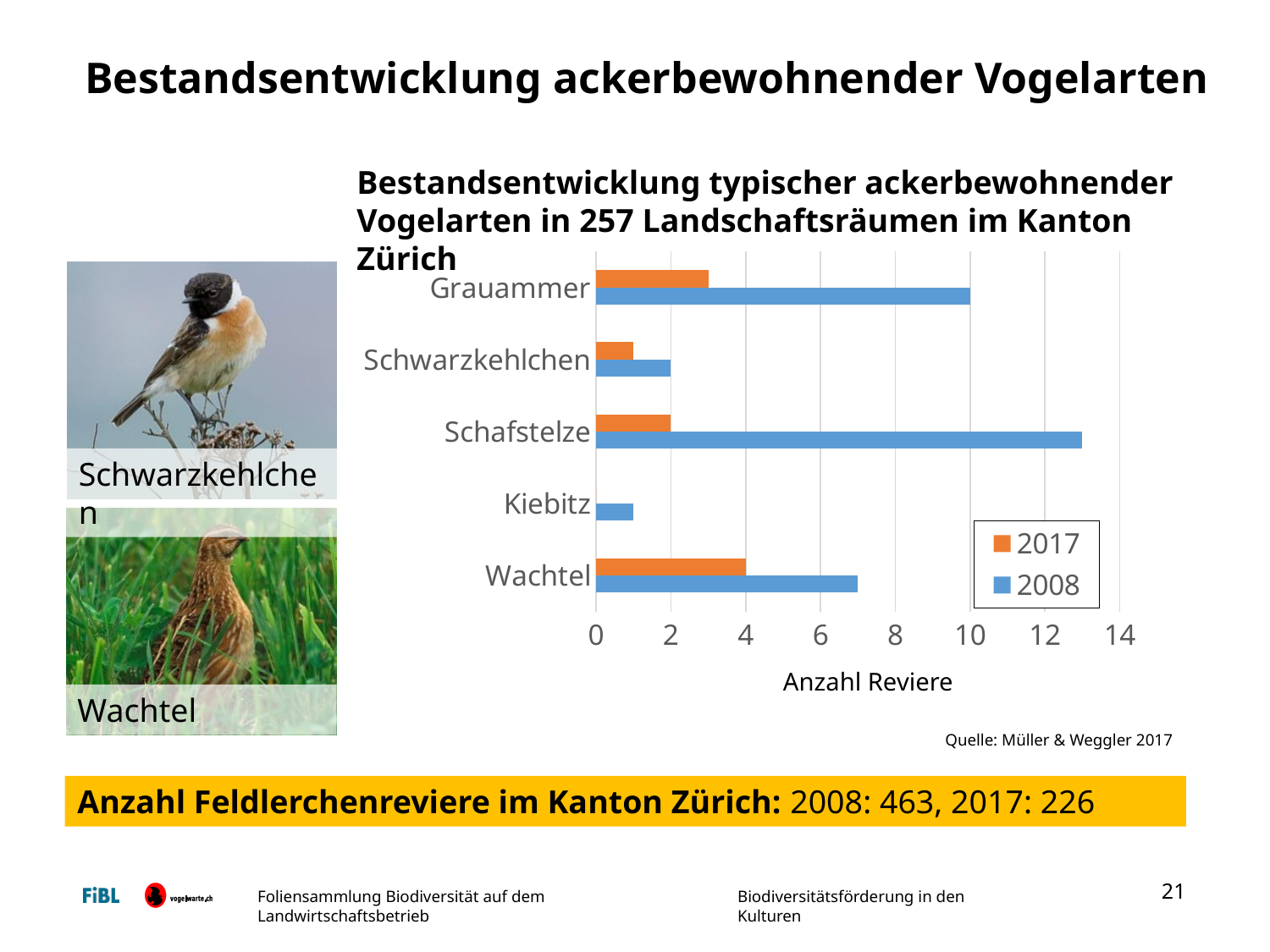
What kind of chart is shown on the slide? bar chart Which species has the highest value for 2008? Schafstelze What is the title of the horizontal axis? Anzahl Reviere What is the value for Wachtel in 2017? 4 Which species has the highest value for 2017? Wachtel Is the value for Schafstelze in 2008 greater or less than 12? greater Which species has the lowest value for 2008? Kiebitz How many bird species (categories) are shown on the chart? 5 For Grauammer, which year has the larger value, 2008 or 2017? 2008 What is the value for Grauammer in 2008? 10 How many series does the chart legend list? 2 What is the value for Schafstelze in 2017? 2